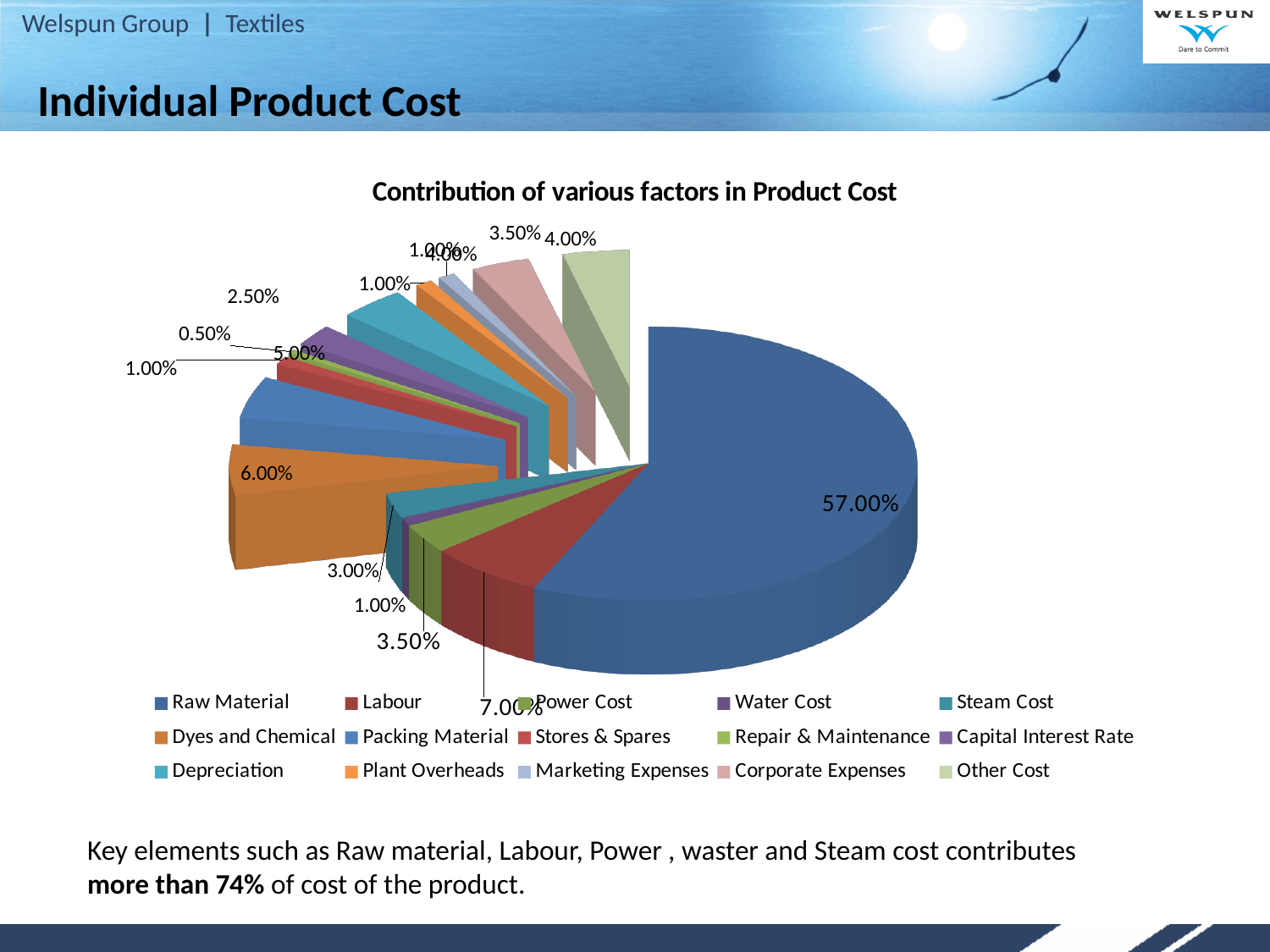
What is the value shown for Other Cost? 4.00% What is the title of the chart? Contribution of various factors in Product Cost Which cost factor has the largest share of product cost? Raw Material What is the difference between the Raw Material share and the Labour share? 50.00% How many cost factors does the legend list? 15 What is the value shown for Labour? 7.00% What share of product cost is Raw Material? 57.00% What is the value shown for Power Cost? 3.50% What is the smallest percentage value labelled on the chart? 0.50% What is the value shown for Dyes and Chemical? 6.00% Which is larger, the share for Labour or the share for Dyes and Chemical? Labour What kind of chart is shown on the slide? pie chart